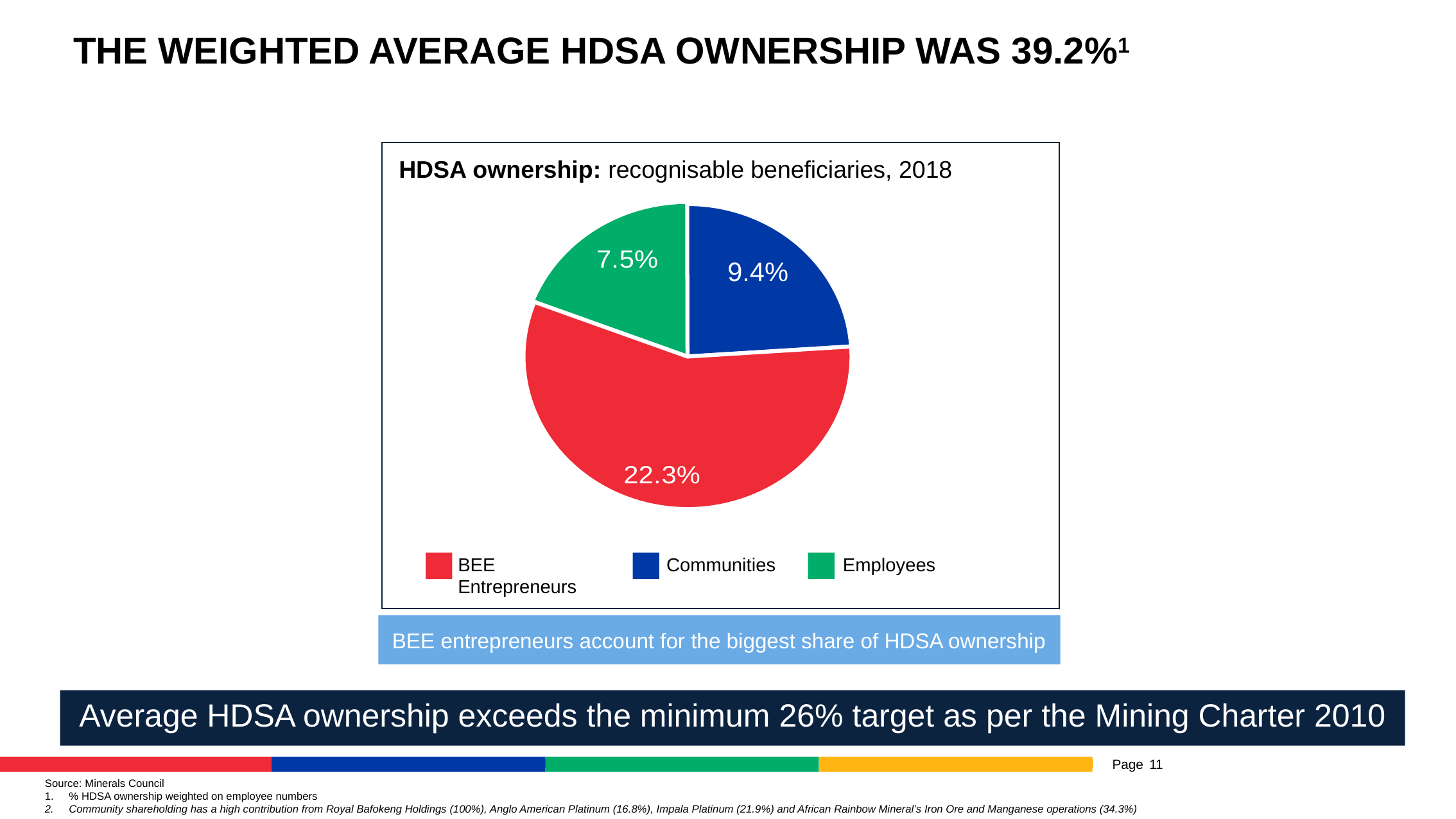
What colour is the Employees slice in the pie chart? green What is the difference between the values for Communities and Employees? 1.9% What is the value shown for Communities in the pie chart? 9.4% Which category has the largest slice of the pie chart? BEE Entrepreneurs What is the difference between the values for BEE Entrepreneurs and Communities? 12.9% What type of chart is shown on the slide? pie chart Which category has the smallest slice of the pie chart? Employees How many categories does the pie chart show? 3 What is the sum of the three values shown in the pie chart? 39.2% What is the value shown for BEE Entrepreneurs in the pie chart? 22.3% Which is larger, the value for Communities or the value for Employees? Communities What is the value shown for Employees in the pie chart? 7.5%